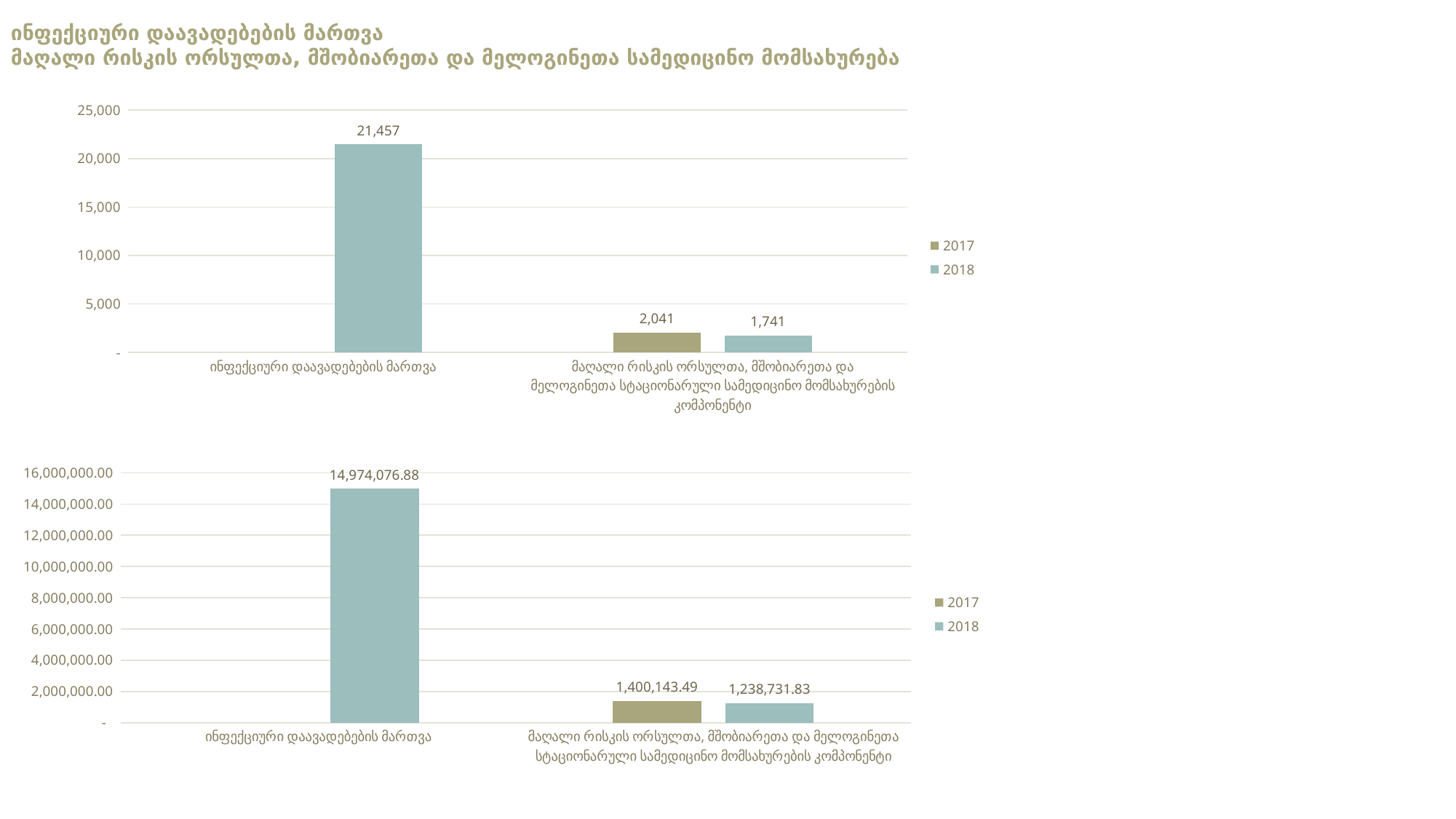
In the bottom chart, which bar is the highest? ინფექციური დაავადებების მართვა (2018) How many categories are shown on the x axis of the top chart? 2 In the top chart, what is the 2017 value for the მაღალი რისკის ორსულთა, მშობიარეთა და მელოგინეთა სტაციონარული სამედიცინო მომსახურების კომპონენტი category? 2,041 In the top chart, what is the 2018 value for ინფექციური დაავადებების მართვა? 21,457 In the top chart, what is the 2018 value for the მაღალი რისკის ორსულთა, მშობიარეთა და მელოგინეთა სტაციონარული სამედიცინო მომსახურების კომპონენტი category? 1,741 In the top chart, which series has the larger value for the მაღალი რისკის ორსულთა category, 2017 or 2018? 2017 What kind of chart is the bottom chart? Bar chart How many series does the legend of the top chart list? 2 In the bottom chart, what is the 2017 value for the მაღალი რისკის ორსულთა, მშობიარეთა და მელოგინეთა სტაციონარული სამედიცინო მომსახურების კომპონენტი category? 1,400,143.49 In the bottom chart, what is the 2018 value for ინფექციური დაავადებების მართვა? 14,974,076.88 In the bottom chart, what is the 2018 value for the მაღალი რისკის ორსულთა, მშობიარეთა და მელოგინეთა სტაციონარული სამედიცინო მომსახურების კომპონენტი category? 1,238,731.83 In the top chart, what is the difference between the 2017 and 2018 values for the მაღალი რისკის ორსულთა category? 300